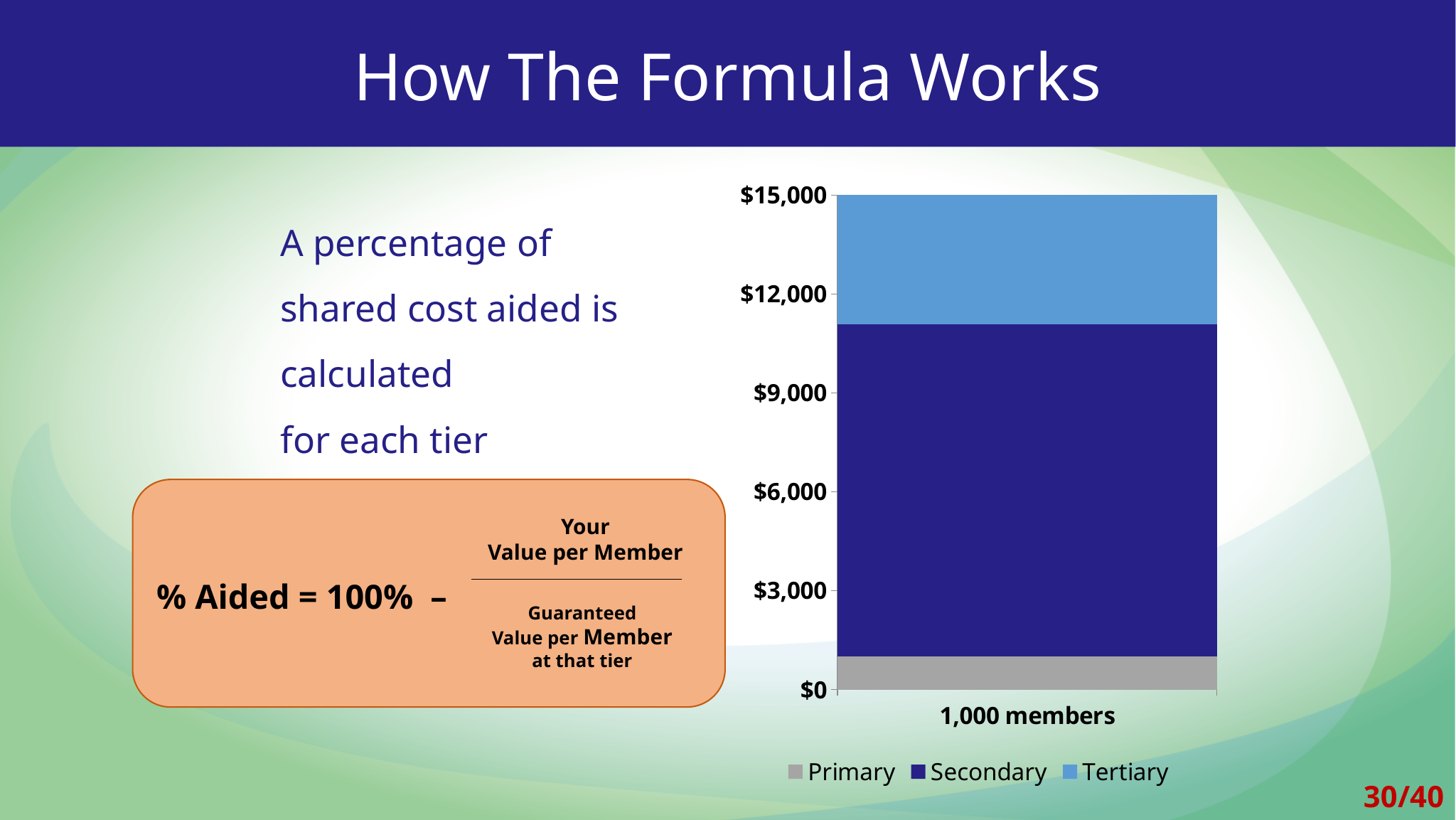
Is the Secondary segment of the bar greater or less than $6,000? greater Is the Tertiary segment of the bar greater or less than $6,000? less Is the Primary segment of the bar greater or less than $3,000? less What is the total height of the stacked bar for 1,000 members? $15,000 Which series makes up the smallest segment of the stacked bar? Primary How many series does the chart legend list? 3 What kind of chart is shown on the slide? Stacked bar chart What is the category label on the x axis of the chart? 1,000 members Which segment is larger, Secondary or Tertiary? Secondary What are the series names listed in the chart legend? Primary, Secondary, Tertiary Which series makes up the largest segment of the stacked bar? Secondary How many categories are shown on the x axis of the chart? 1